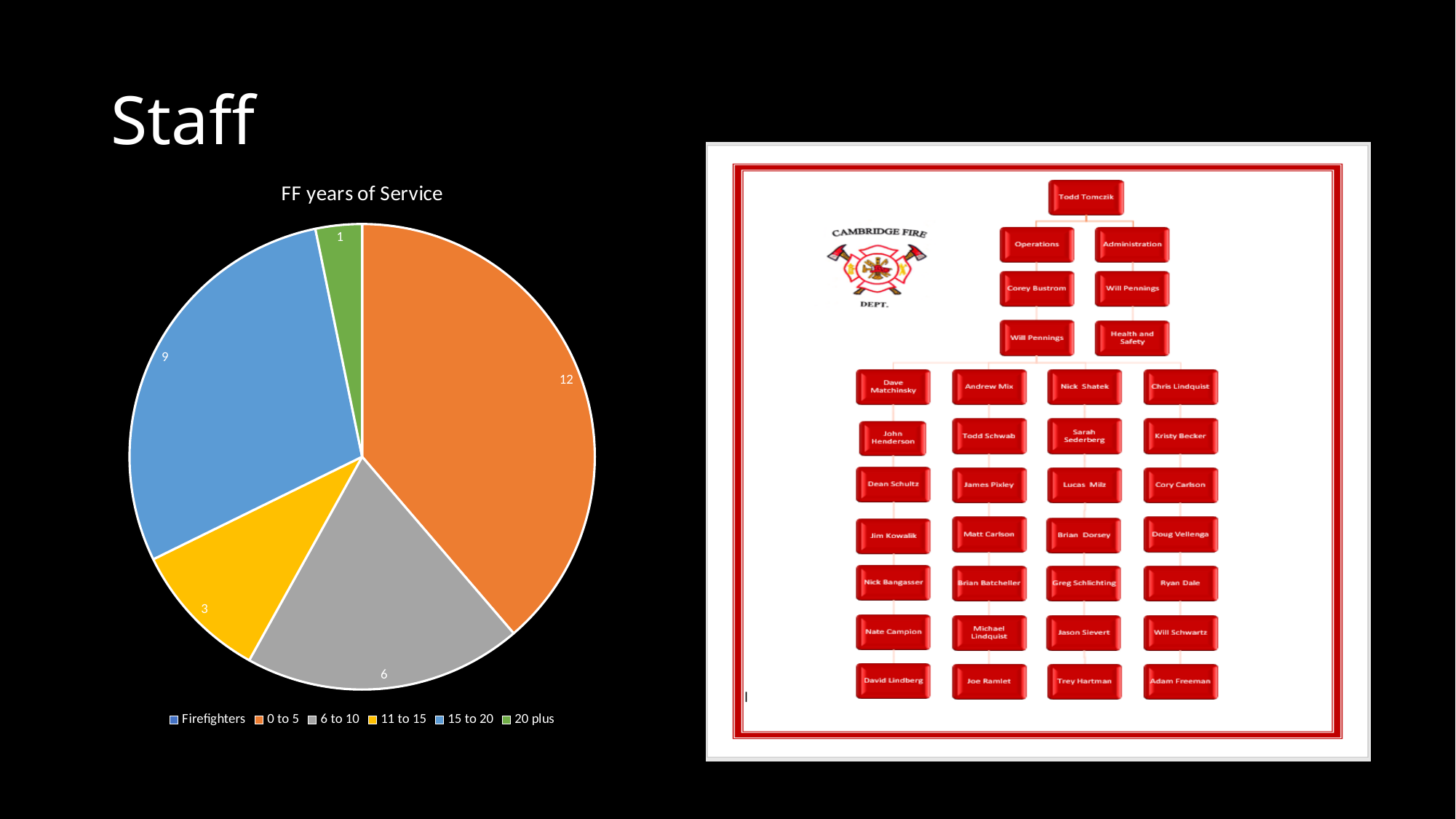
Which category has the largest slice in the FF years of Service pie chart? 0 to 5 In the FF years of Service pie chart, what is the value for the 20 plus slice? 1 In the FF years of Service pie chart, what is the value for the 15 to 20 slice? 9 In the FF years of Service pie chart, what is the value for the 0 to 5 slice? 12 Which category has the smallest slice in the FF years of Service pie chart? 20 plus In the FF years of Service pie chart, what is the difference between the 0 to 5 value and the 15 to 20 value? 3 What is the sum of all the slice values in the FF years of Service pie chart? 31 In the FF years of Service pie chart, which is larger: 6 to 10 or 15 to 20? 15 to 20 In the FF years of Service pie chart, what is the value for the 11 to 15 slice? 3 In the FF years of Service pie chart, what is the value for the 6 to 10 slice? 6 What kind of chart is the FF years of Service chart? Pie chart How many slices are shown in the FF years of Service pie chart? 5